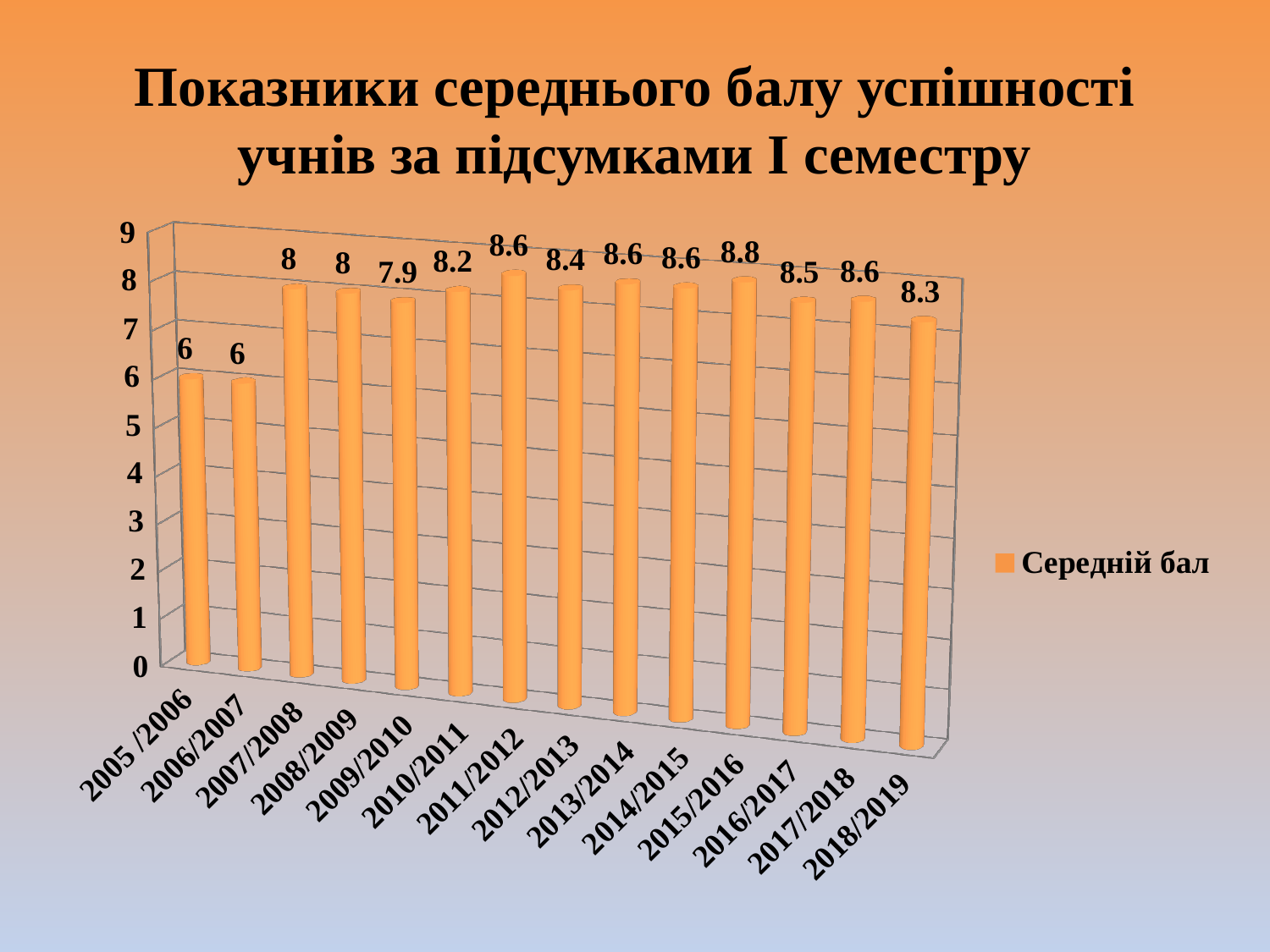
Which is larger, the average score for 2012/2013 or 2013/2014? 2013/2014 What is the average score for 2018/2019? 8.3 Which academic year has the highest average score? 2015/2016 What kind of chart is shown on the slide? bar chart Is the value for 2006/2007 greater or less than 7? less What is the legend entry for the series shown? Середній бал How many academic years are shown on the x axis? 14 What is the average score for 2015/2016? 8.8 What is the difference between the average score for 2015/2016 and 2005/2006? 2.8 What is the average score for 2009/2010? 7.9 How many series does the legend list? 1 What is the difference between the average score for 2017/2018 and 2018/2019? 0.3